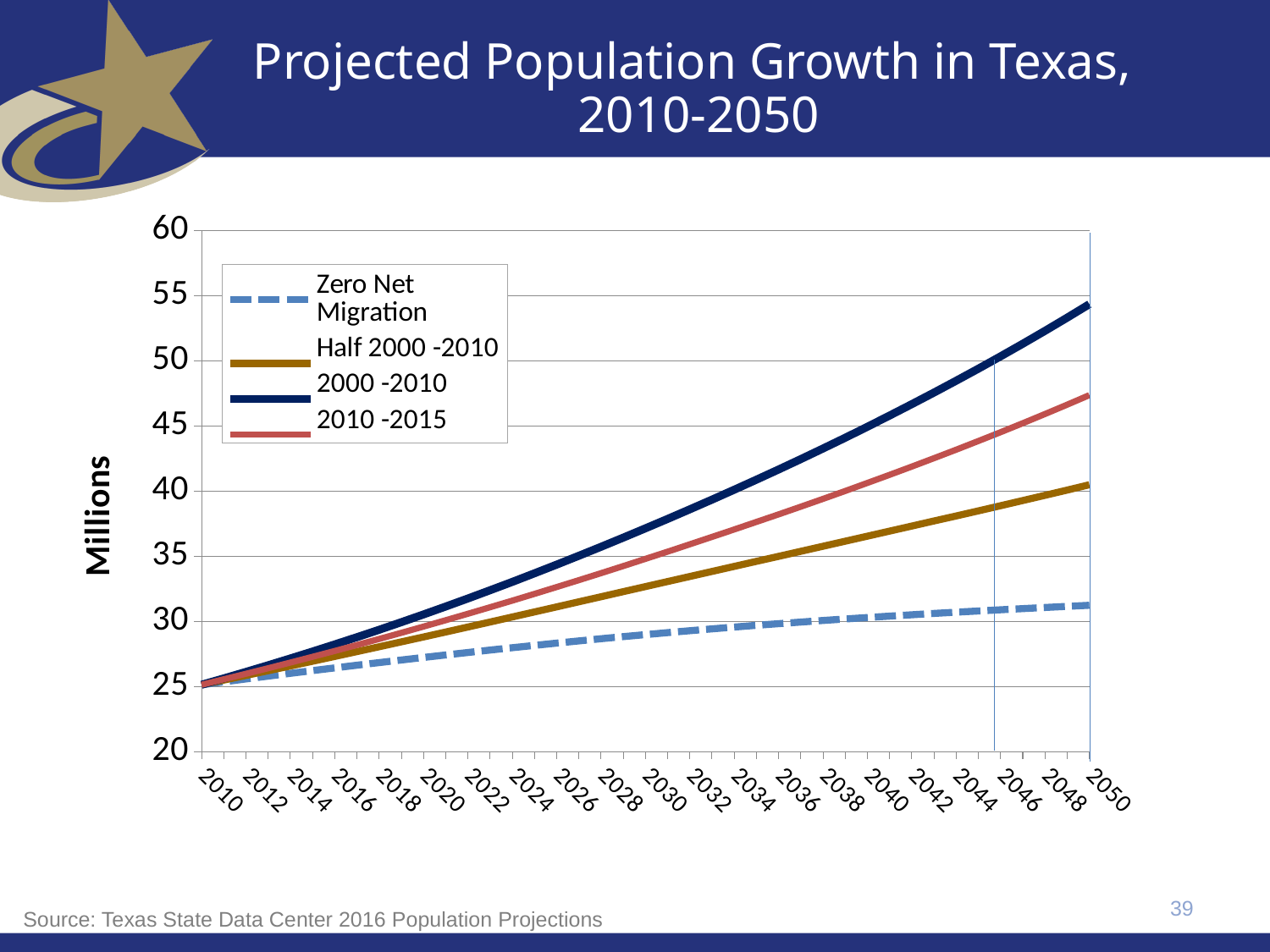
In 2050, which is larger: the 2010 -2015 series or the Half 2000 -2010 series? 2010 -2015 Is the value for the 2010 -2015 series in 2050 greater or less than 50? less Is the value for the 2000 -2010 series in 2050 greater or less than 50? greater Which series has the lowest projected population in 2050? Zero Net Migration How many series does the legend list? 4 How many year labels are shown on the x axis? 21 What kind of chart is shown on the slide? line chart Is the value for the Zero Net Migration series in 2030 greater or less than 30? less Do the values of the 2000 -2010 series rise or fall from 2010 to 2050? rise Which series has the highest projected population in 2050? 2000 -2010 What is the label on the vertical axis? Millions